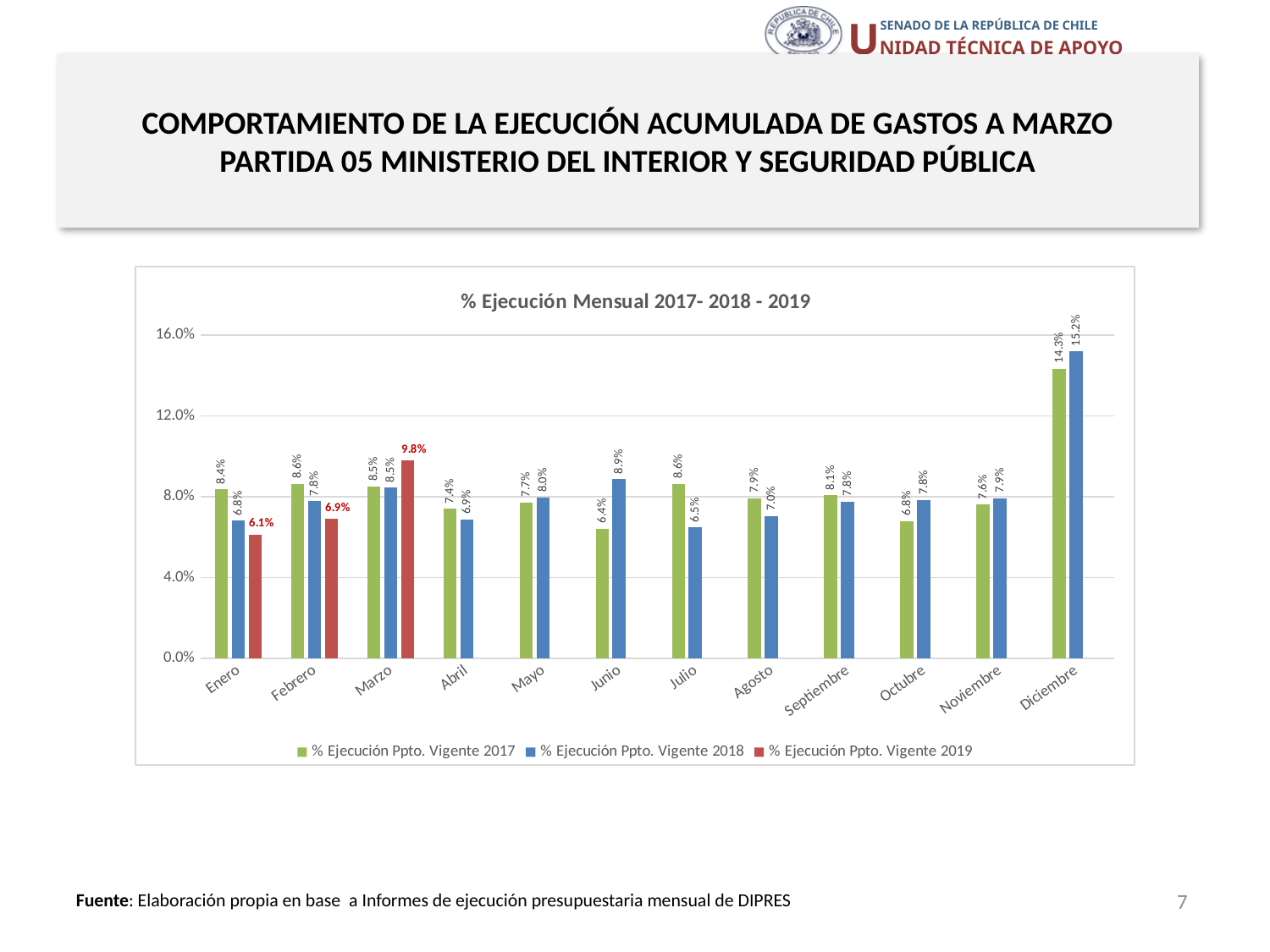
Which month has the lowest value in the % Ejecución Ppto. Vigente 2018 series? Julio Is the value for Diciembre in the 2017 series greater or less than 12.0%? greater Which month has the highest value in the % Ejecución Ppto. Vigente 2017 series? Diciembre What is the value for Marzo in the % Ejecución Ppto. Vigente 2019 series? 9.8% What is the value for Diciembre in the % Ejecución Ppto. Vigente 2018 series? 15.2% What is the title of the chart? % Ejecución Mensual 2017- 2018 - 2019 How many series does the legend list? 3 How many months are shown on the x axis? 12 What is the value for Junio in the % Ejecución Ppto. Vigente 2017 series? 6.4% Which is larger for Junio: the 2017 value or the 2018 value? 2018 What kind of chart is shown on the slide? bar chart What is the difference between the 2018 and 2019 values for Enero? 0.7%